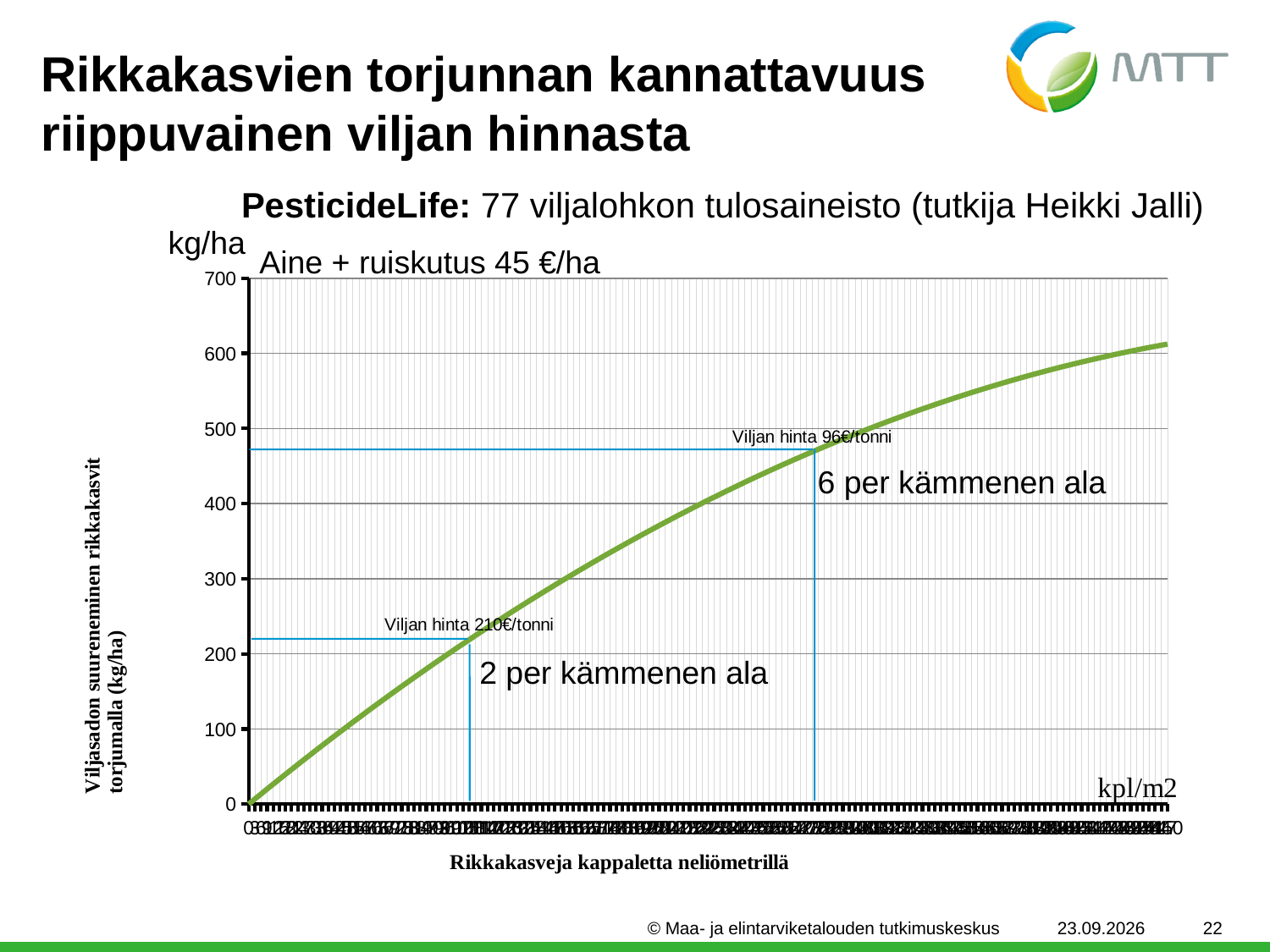
What is the highest tick value shown on the y axis? 700 Is the yield increase at the point marked "Viljan hinta 96€/tonni" greater or less than 500 kg/ha? less Is the yield increase at the point marked "Viljan hinta 210€/tonni" greater or less than 100 kg/ha? greater Does the plotted curve rise or fall as the number of weeds per square metre increases along the x axis? rise Is the yield increase at the point marked "Viljan hinta 96€/tonni" greater or less than 400 kg/ha? greater Which marked point has the higher yield increase: "Viljan hinta 96€/tonni" or "Viljan hinta 210€/tonni"? Viljan hinta 96€/tonni What kind of chart is shown on the slide? line chart What is the title of the x axis of the chart? Rikkakasveja kappaletta neliömetrillä How many lines (data series) are plotted on the chart? 1